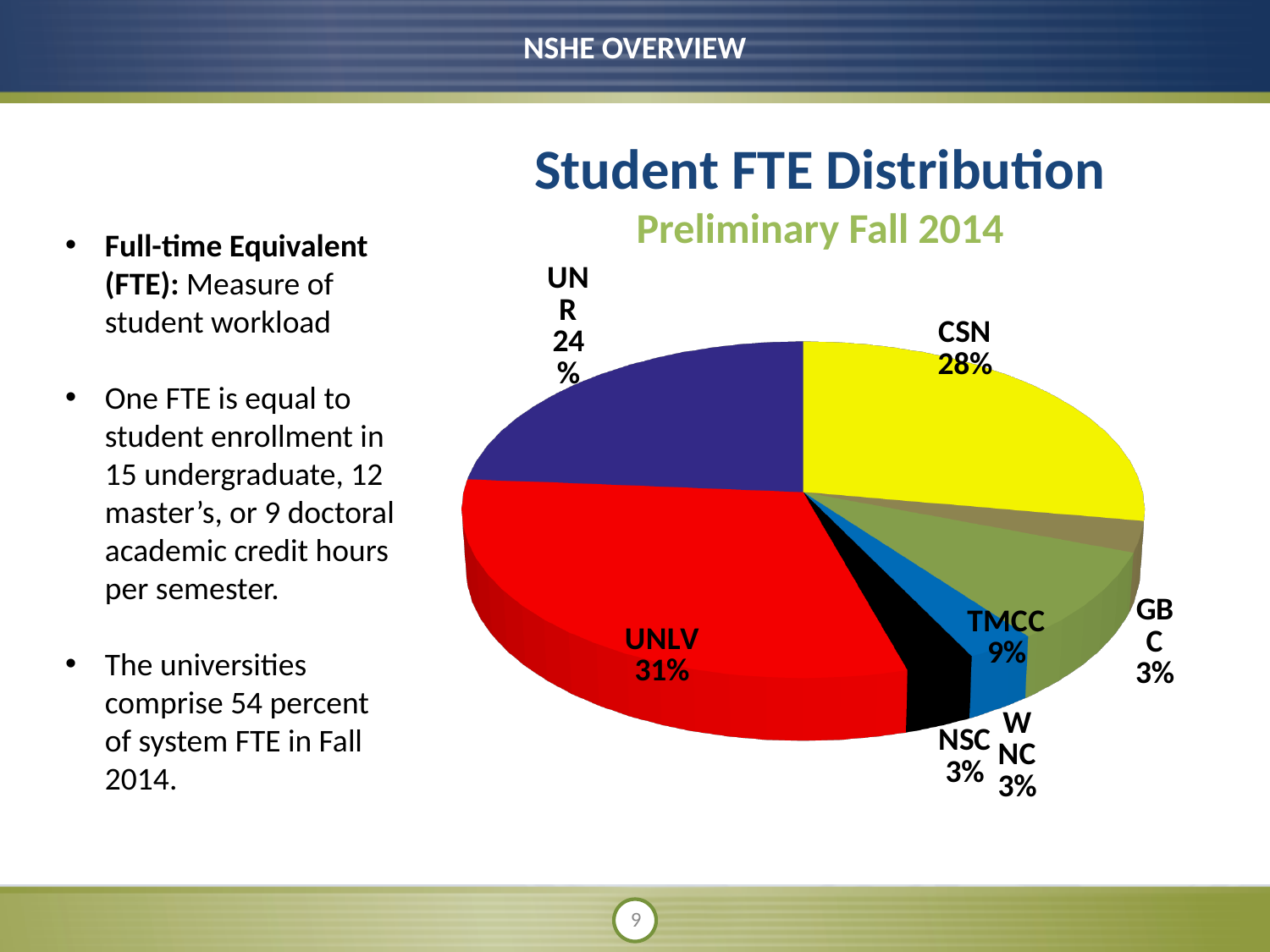
How many institutions are shown as slices in the pie chart? 7 What is the title of the chart? Student FTE Distribution Preliminary Fall 2014 Which is larger, the share for UNR or the share for TMCC? UNR What share of the pie does CSN hold? 28% What is the difference in percentage points between UNLV's share and CSN's share? 3 What kind of chart is shown on the slide? Pie chart What share of the pie does TMCC hold? 9% What is the difference in percentage points between CSN's share and UNR's share? 4 What share of the pie does UNR hold? 24% Which is larger, the share for CSN or the share for UNLV? UNLV Which institution has the largest slice of the pie? UNLV